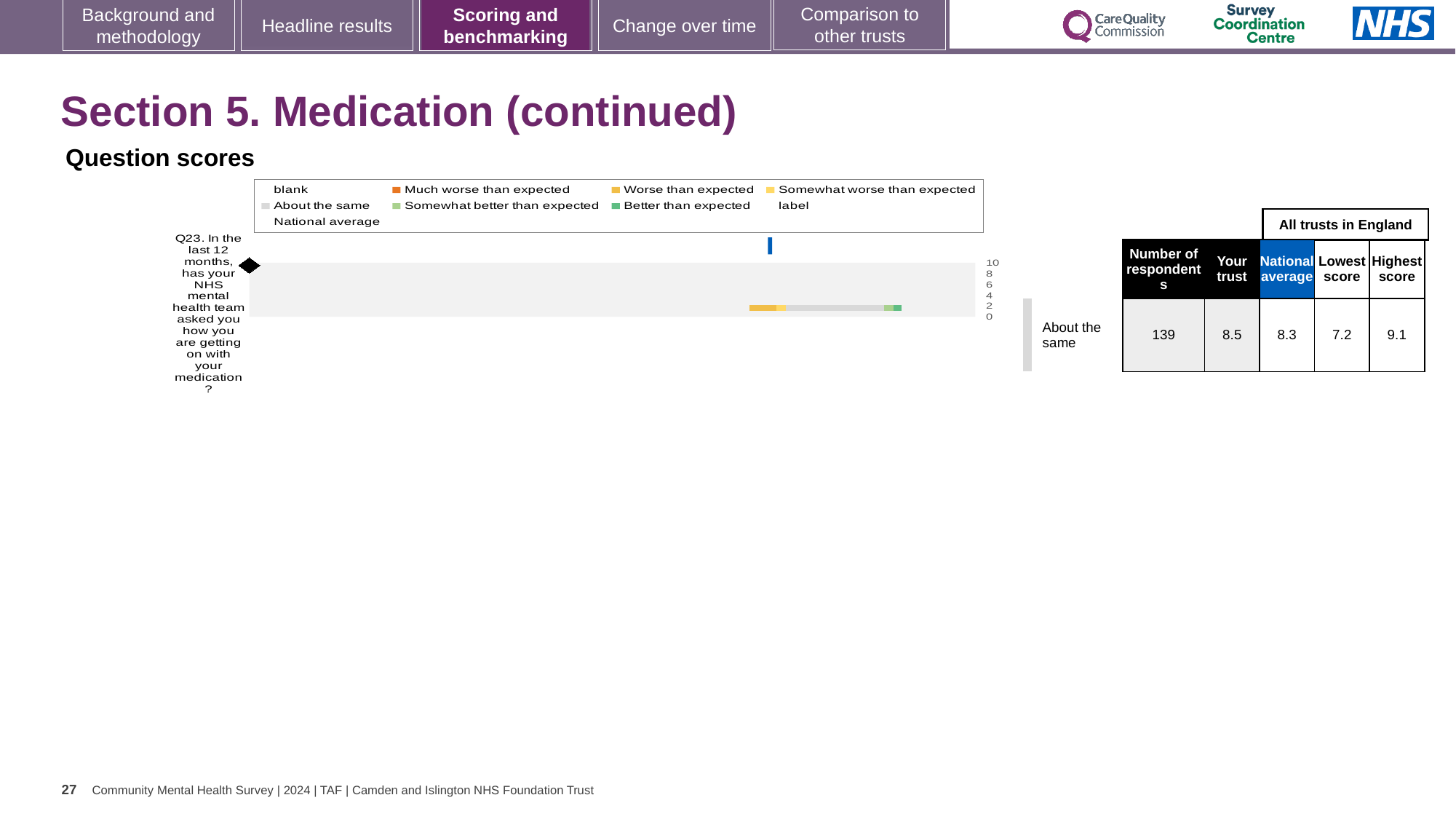
How many survey questions are plotted in the chart? 1 How many respondents answered Q23 according to the table beside the chart? 139 What is the 'Your trust' score for Q23 in the table beside the chart? 8.5 What is the highest score among all trusts in England for Q23? 9.1 What is the national average score for Q23 in the table beside the chart? 8.3 What colour does the legend use for 'Much worse than expected'? orange For Q23, which is larger: the 'Your trust' score or the national average? Your trust For Q23, what is the difference between the highest score and the lowest score among all trusts in England? 1.9 What kind of chart is shown under 'Question scores'? bar chart Which benchmark category is shown next to the bar for Q23? About the same What is the lowest score among all trusts in England for Q23? 7.2